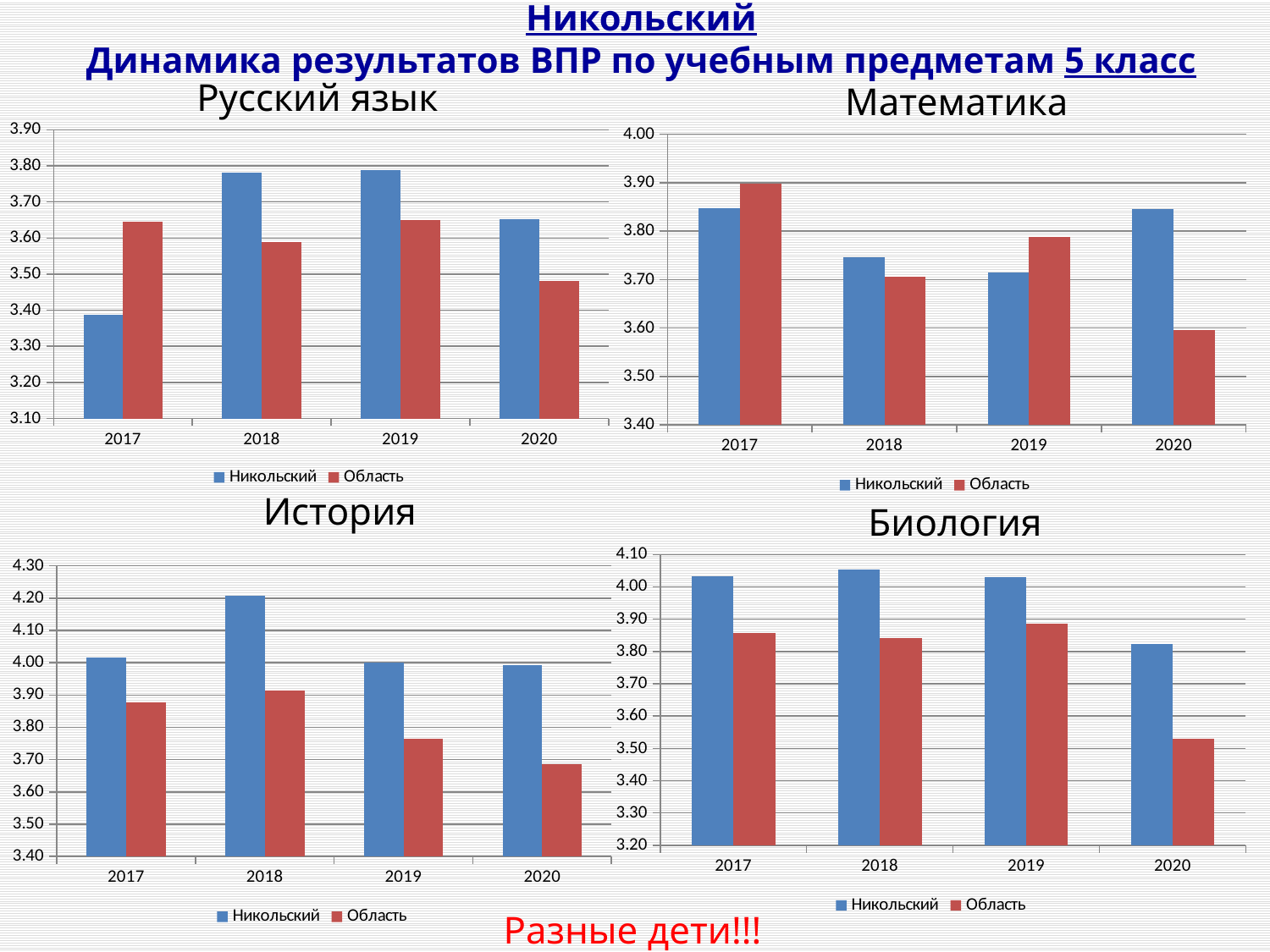
In the Математика chart, which year has the lowest value for Область? 2020 In the Русский язык chart, which year has the lowest value for Никольский? 2017 How many years are shown on the x axis of the Русский язык chart? 4 In the Русский язык chart, is the value for Никольский in 2017 greater or less than 3.40? less How many series does the legend of the Биология chart list? 2 In the История chart, do the values for Область rise or fall from 2018 to 2020? fall In the Математика chart, is the value for Область in 2017 greater or less than 3.80? greater In the Биология chart, which year has the lowest value for Область? 2020 In the История chart, is the value for Никольский in 2018 greater or less than 4.10? greater In the Математика chart, which is larger in 2017: Никольский or Область? Область In the История chart, which year has the highest value for Никольский? 2018